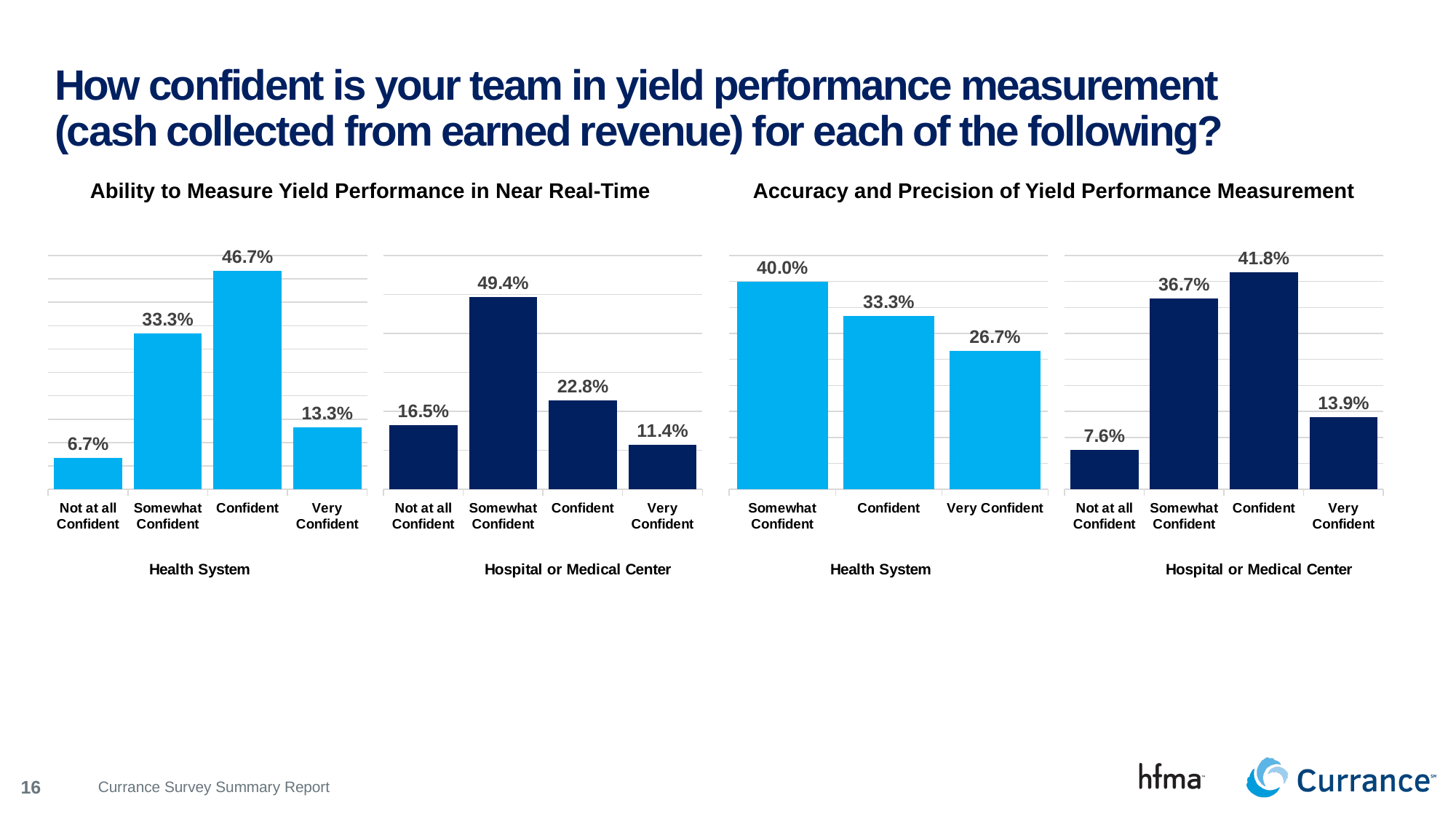
In the 'Ability to Measure Yield Performance in Near Real-Time' chart, what is the value for Somewhat Confident in the Hospital or Medical Center group? 49.4% In the 'Accuracy and Precision of Yield Performance Measurement' chart, which is larger: Very Confident for Health System or Very Confident for Hospital or Medical Center? Health System What kind of chart is the 'Ability to Measure Yield Performance in Near Real-Time' chart? Bar chart In the 'Accuracy and Precision of Yield Performance Measurement' chart, which category has the highest value in the Health System group? Somewhat Confident In the 'Ability to Measure Yield Performance in Near Real-Time' chart, what is the difference between Confident and Somewhat Confident in the Health System group? 13.4% In the 'Accuracy and Precision of Yield Performance Measurement' chart, what is the difference between Confident and Very Confident in the Hospital or Medical Center group? 27.9% What is the title of the chart on the right side of the slide? Accuracy and Precision of Yield Performance Measurement How many categories are shown in the Health System group of the 'Accuracy and Precision of Yield Performance Measurement' chart? 3 In the 'Ability to Measure Yield Performance in Near Real-Time' chart, what is the value for Confident in the Health System group? 46.7% In the 'Ability to Measure Yield Performance in Near Real-Time' chart, which category has the lowest value in the Hospital or Medical Center group? Very Confident In the 'Accuracy and Precision of Yield Performance Measurement' chart, what is the value for Not at all Confident in the Hospital or Medical Center group? 7.6% How many categories are shown in the Hospital or Medical Center group of the 'Ability to Measure Yield Performance in Near Real-Time' chart? 4